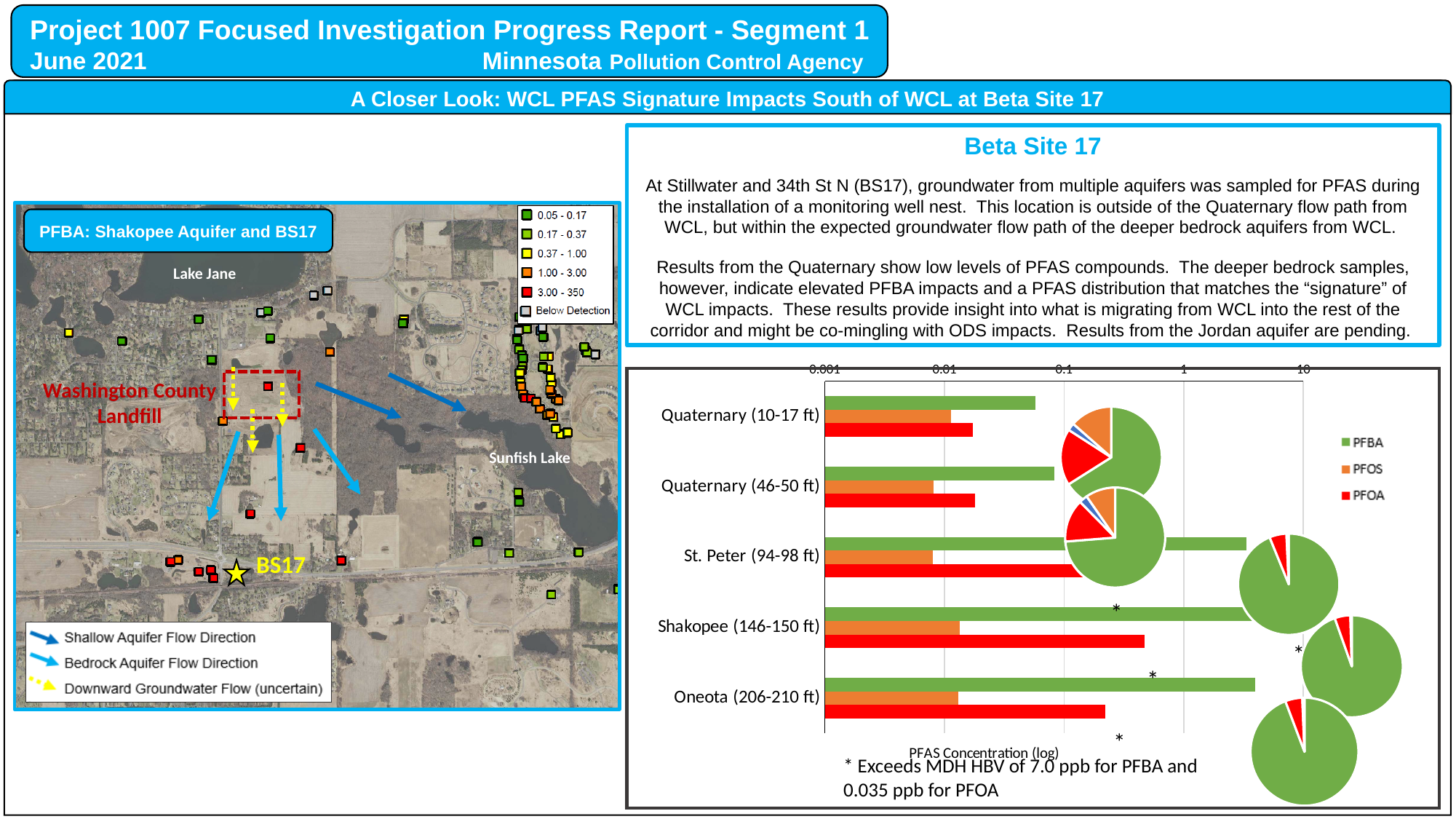
Which category has the highest PFBA concentration on the bar chart? Shakopee (146-150 ft) How many aquifer depth categories are shown on the PFAS concentration bar chart? 5 Which colour represents PFOS in the bar chart legend? orange What kind of chart is used to show PFAS concentrations at Beta Site 17? bar chart Is the PFBA value for Shakopee (146-150 ft) greater or less than 1? greater For St. Peter (94-98 ft), which is larger: the PFBA value or the PFOA value? PFBA Which category has the highest PFOA concentration on the bar chart? Shakopee (146-150 ft) Is the PFBA value for Quaternary (10-17 ft) greater or less than 0.1? less How many series does the legend of the PFAS concentration bar chart list? 3 Is the PFOA value for Shakopee (146-150 ft) greater or less than 0.1? greater What is the x-axis title of the PFAS concentration bar chart? PFAS Concentration (log)